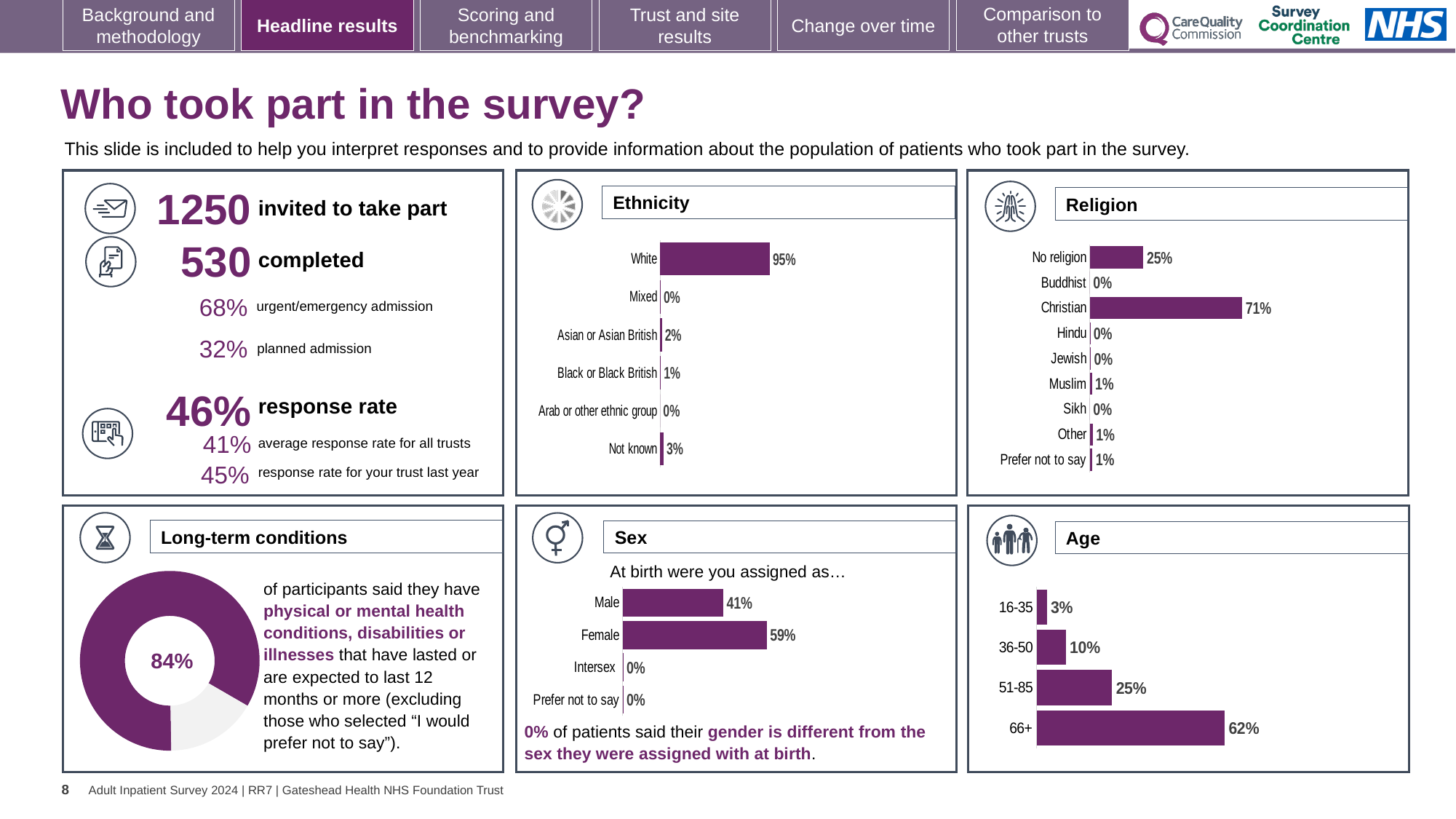
In the Sex chart, what percentage of respondents were Female? 59% How many categories does the Ethnicity chart show? 6 In the Sex chart, which is larger, Male or Female? Female In the Age chart, do the values rise or fall as age increases from 16-35 to 66+? rise How many categories does the Religion chart show? 9 In the Religion chart, what is the difference between the Christian and No religion values? 46% In the Ethnicity chart, what percentage of respondents were White? 95% In the Religion chart, what percentage of respondents were Christian? 71% In the Age chart, which age group has the lowest value? 16-35 In the Long-term conditions chart, what share of participants said they have long-term conditions? 84% In the Ethnicity chart, which category has the highest value? White In the Age chart, what percentage of respondents were aged 66+? 62%